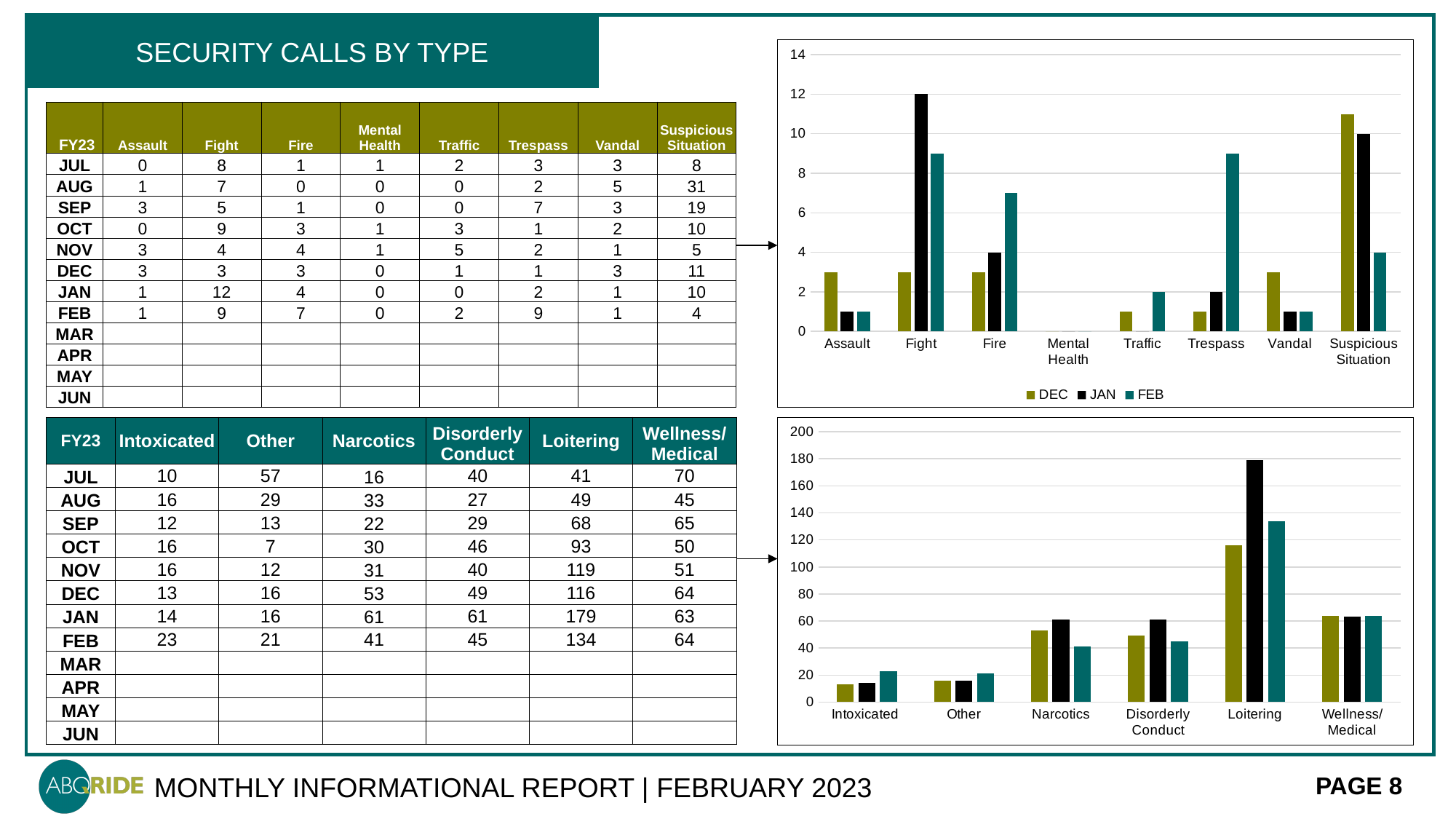
In the top chart, which category has no bars at all for DEC, JAN or FEB? Mental Health How many categories are shown on the x axis of the bottom chart? 6 In the top chart, what is the JAN value for Fight? 12 In the bottom chart, what is the FEB value for Loitering? 134 What kind of chart is the top chart on the slide? bar chart In the bottom chart, what is the difference between the JAN and FEB values for Loitering? 45 In the top chart, which is larger: the FEB value for Trespass or the FEB value for Fire? Trespass In the bottom chart, which category has the highest JAN value? Loitering How many categories are shown on the x axis of the top chart? 8 In the top chart's legend, which series is shown in black? JAN How many series does the legend of the top chart list? 3 In the bottom chart, is the JAN value for Loitering greater or less than 160? greater